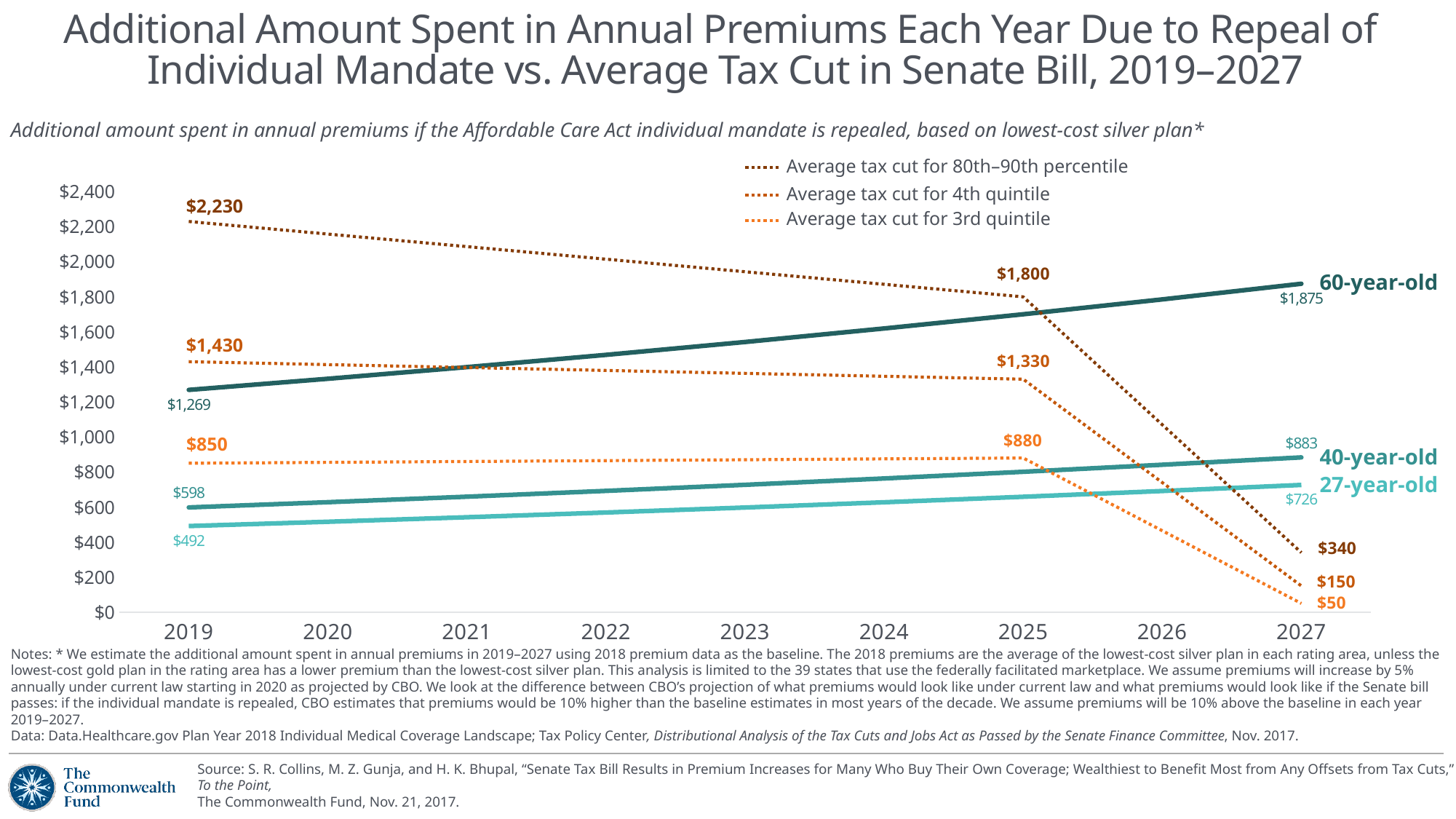
Which series has the highest value in 2019? Average tax cut for 80th–90th percentile What is the additional amount spent in annual premiums for a 60-year-old in 2019? $1,269 What is the average tax cut for the 80th–90th percentile in 2025? $1,800 What type of chart is shown on the slide? Line chart What is the additional amount spent in annual premiums for a 27-year-old in 2027? $726 Which series has the lowest value in 2027? Average tax cut for 3rd quintile How many years are shown on the x axis? 9 Does the average tax cut for the 4th quintile rise or fall between 2025 and 2027? Fall How much does the additional premium amount for a 40-year-old increase from 2019 to 2027? $285 How many series does the legend list? 3 Which is larger in 2027: the additional premium amount for a 60-year-old or the average tax cut for the 80th–90th percentile? 60-year-old What is the average tax cut for the 3rd quintile in 2027? $50